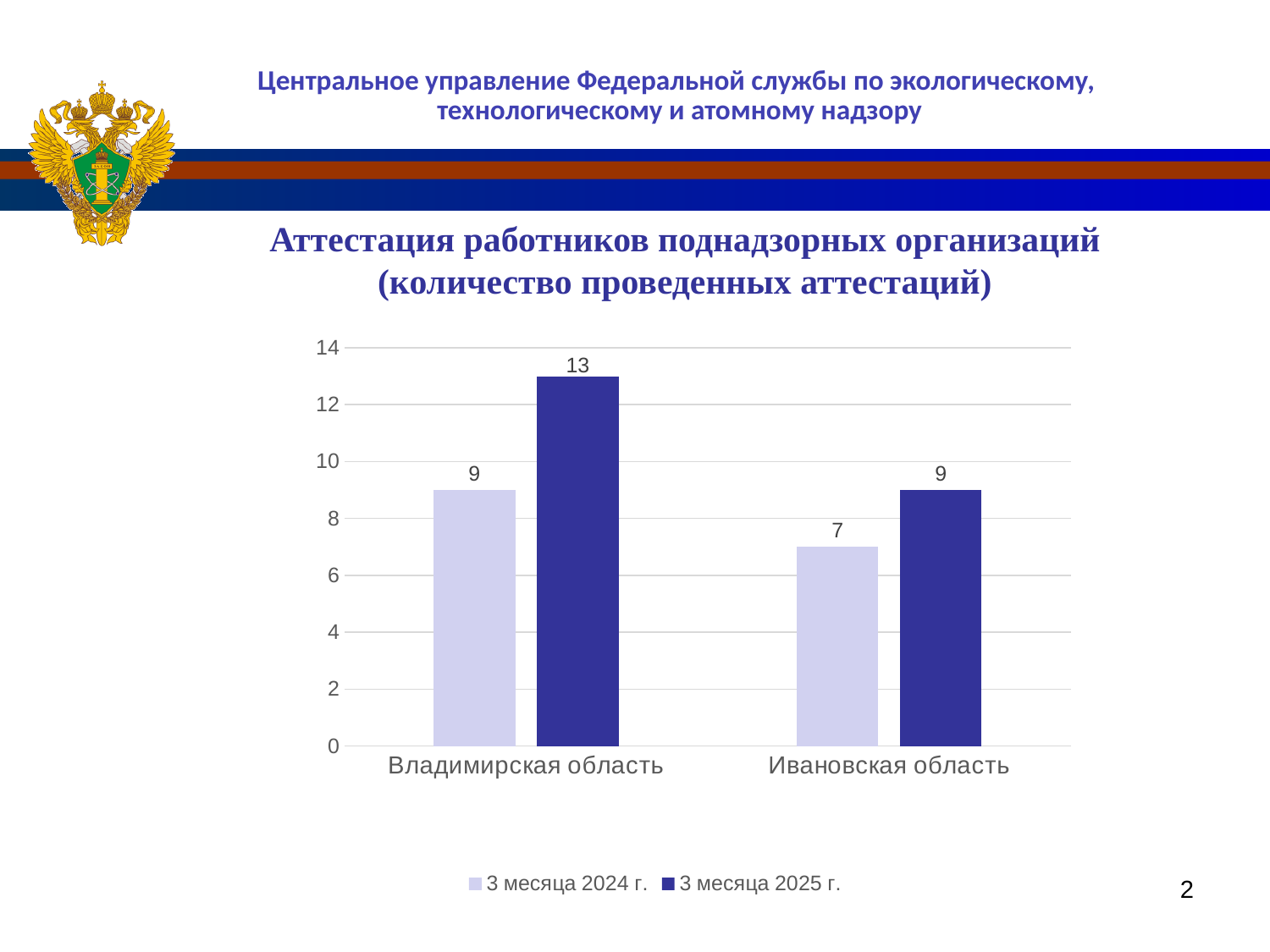
How many categories are shown on the x axis? 2 What is the value for Ивановская область in the series 3 месяца 2025 г.? 9 What is the difference between the 3 месяца 2025 г. and 3 месяца 2024 г. values for Ивановская область? 2 What is the value for Ивановская область in the series 3 месяца 2024 г.? 7 What is the value for Владимирская область in the series 3 месяца 2025 г.? 13 How many series does the legend list? 2 Which is larger: the 3 месяца 2024 г. value for Владимирская область or the 3 месяца 2024 г. value for Ивановская область? Владимирская область What kind of chart is shown on the slide? Bar chart Which category has the highest value in the series 3 месяца 2025 г.? Владимирская область What is the value for Владимирская область in the series 3 месяца 2024 г.? 9 What is the difference between the 3 месяца 2025 г. and 3 месяца 2024 г. values for Владимирская область? 4 Which category has the lowest value in the series 3 месяца 2024 г.? Ивановская область